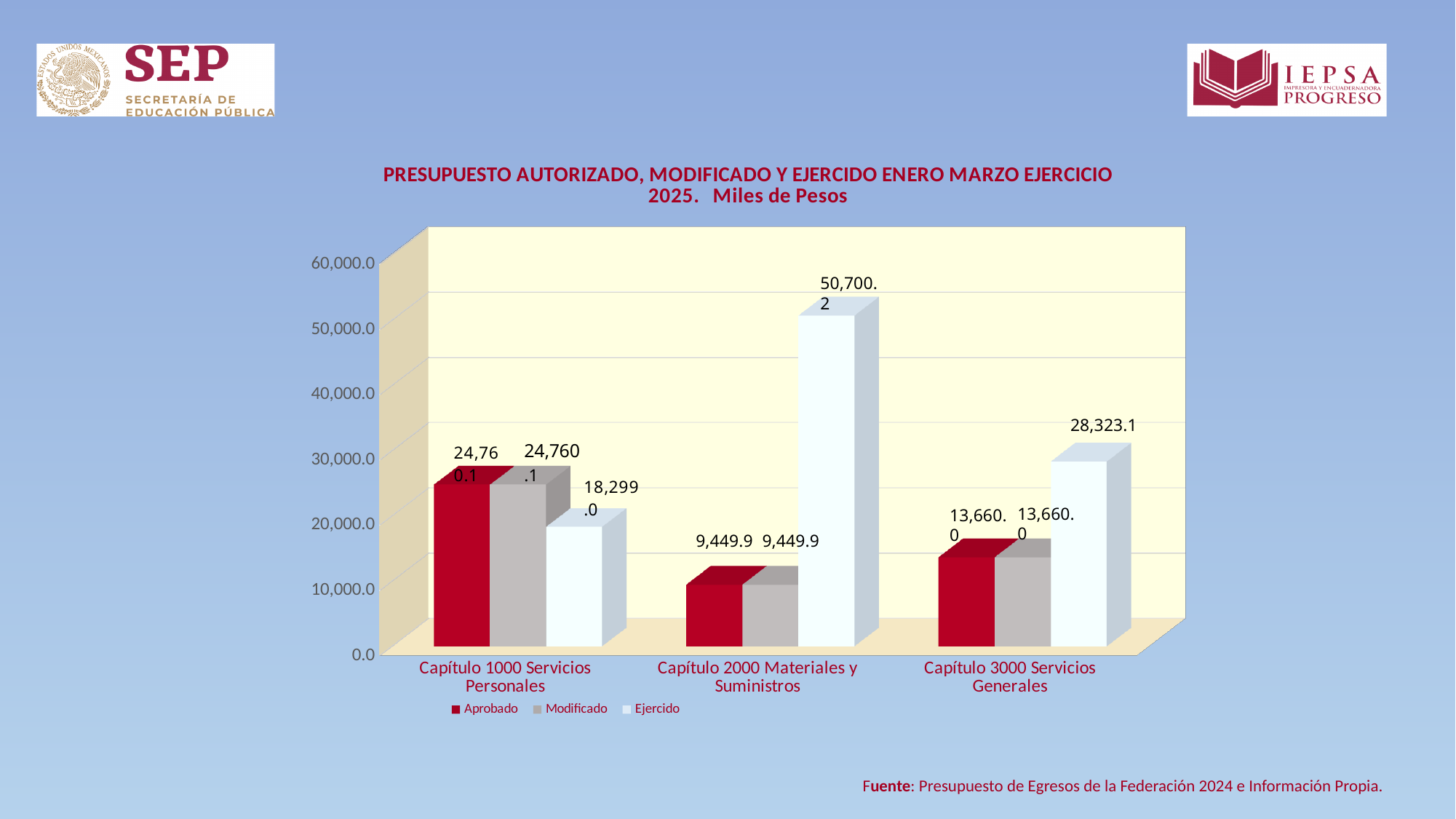
How many series does the legend list? 3 Is the Ejercido value for Capítulo 2000 Materiales y Suministros greater or less than 50,000.0? greater What is the Ejercido value for Capítulo 2000 Materiales y Suministros? 50,700.2 Which is larger for Capítulo 1000 Servicios Personales: the Aprobado value or the Ejercido value? Aprobado What is the Aprobado value for Capítulo 1000 Servicios Personales? 24,760.1 Which category has the highest Ejercido value? Capítulo 2000 Materiales y Suministros What is the Modificado value for Capítulo 2000 Materiales y Suministros? 9,449.9 What is the Ejercido value for Capítulo 3000 Servicios Generales? 28,323.1 Which category has the lowest Aprobado value? Capítulo 2000 Materiales y Suministros How many categories are shown on the x axis? 3 What kind of chart is shown on the slide? Bar chart What is the difference between the Ejercido and Aprobado values for Capítulo 3000 Servicios Generales? 14,663.1